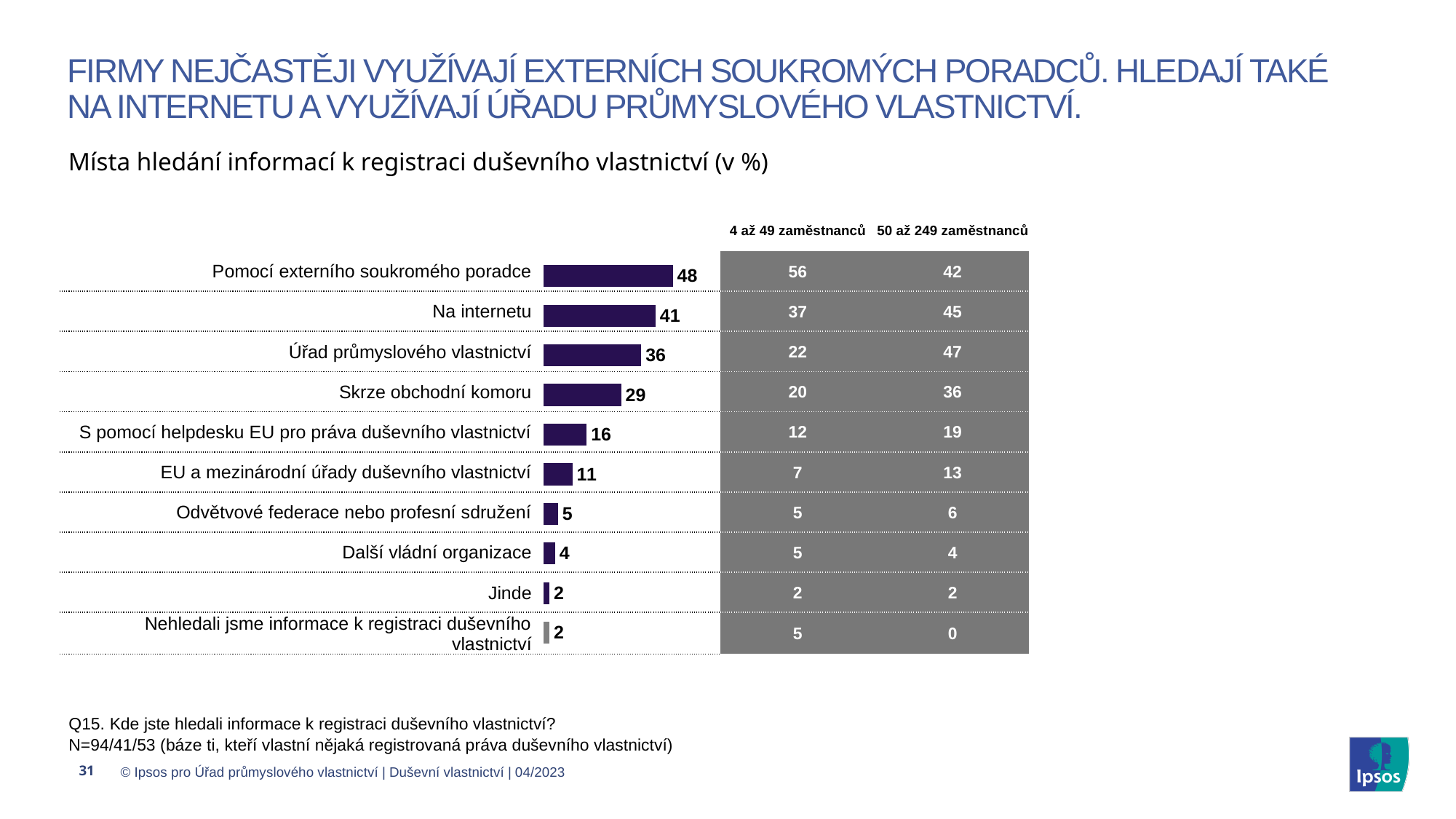
Which category has the highest value in the bar chart? Pomocí externího soukromého poradce What type of chart is shown on the slide? Bar chart What is the value for "Skrze obchodní komoru" in the bar chart? 29 What is the difference between the values for "Na internetu" and "Úřad průmyslového vlastnictví" in the bar chart? 5 What is the subtitle of the chart on the slide? Místa hledání informací k registraci duševního vlastnictví (v %) What is the value for "Pomocí externího soukromého poradce" in the bar chart? 48 How many categories are shown in the bar chart? 10 In the table next to the chart, what is the value for "Pomocí externího soukromého poradce" in the "4 až 49 zaměstnanců" column? 56 In the table next to the chart, what is the value for "Úřad průmyslového vlastnictví" in the "50 až 249 zaměstnanců" column? 47 What is the difference between the values for "Pomocí externího soukromého poradce" and "Jinde" in the bar chart? 46 What is the value for "EU a mezinárodní úřady duševního vlastnictví" in the bar chart? 11 Which is larger in the bar chart: "S pomocí helpdesku EU pro práva duševního vlastnictví" or "Odvětvové federace nebo profesní sdružení"? S pomocí helpdesku EU pro práva duševního vlastnictví